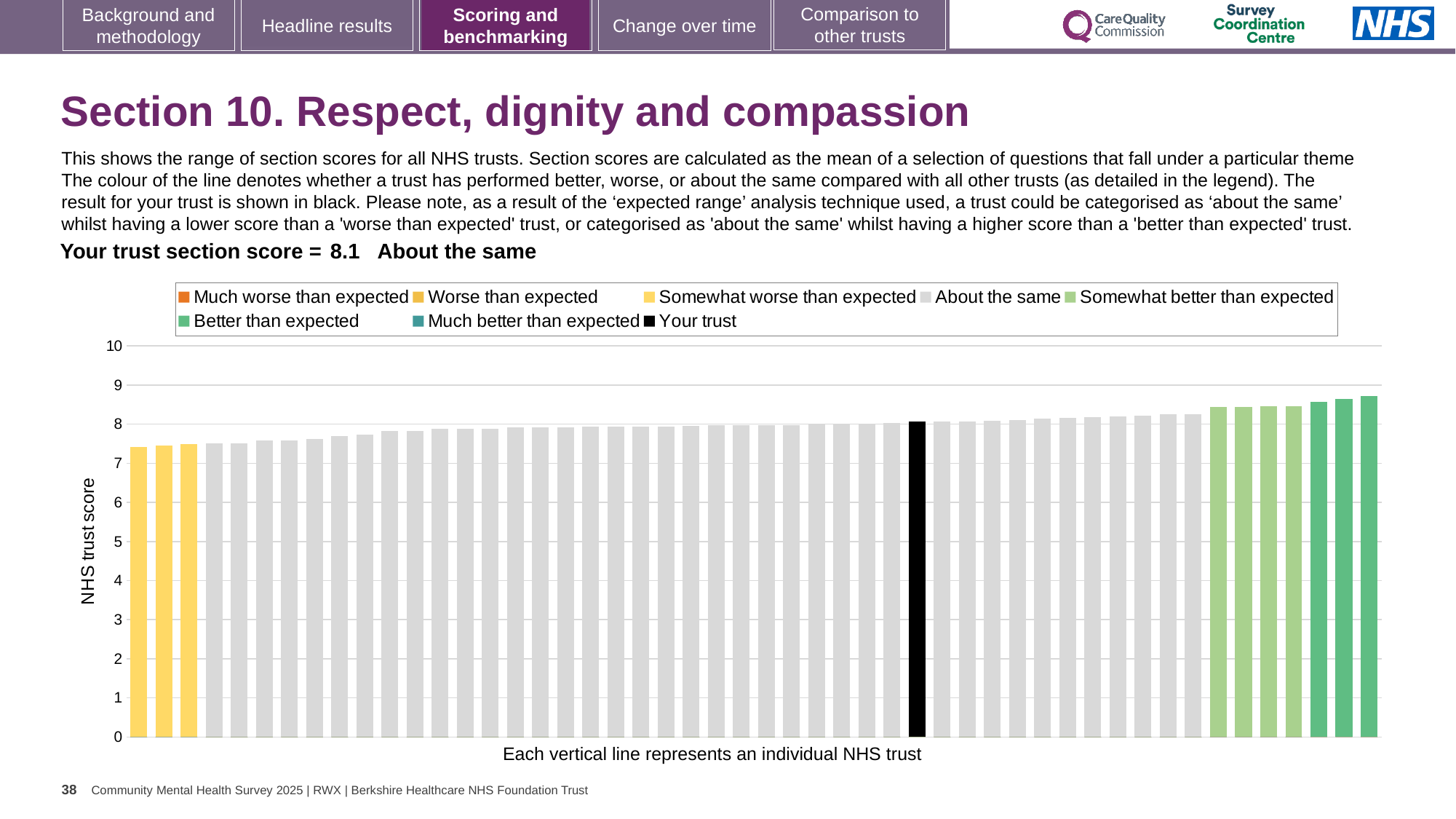
What kind of chart is shown on the slide? bar chart How many entries does the chart legend list? 8 What colour is the bar representing your trust? black Is the value for the highest bar greater or less than 9? less What is the section score for your trust? 8.1 Is the value for the lowest bar greater or less than 7? greater Which category is your trust placed in for this section? About the same What is the title of the vertical axis? NHS trust score How many bars are coloured yellow (Somewhat worse than expected)? 3 How many bars are coloured light green (Somewhat better than expected)? 4 Is the value for your trust greater or less than 8? greater Do the bar values rise or fall from left to right along the x axis? rise